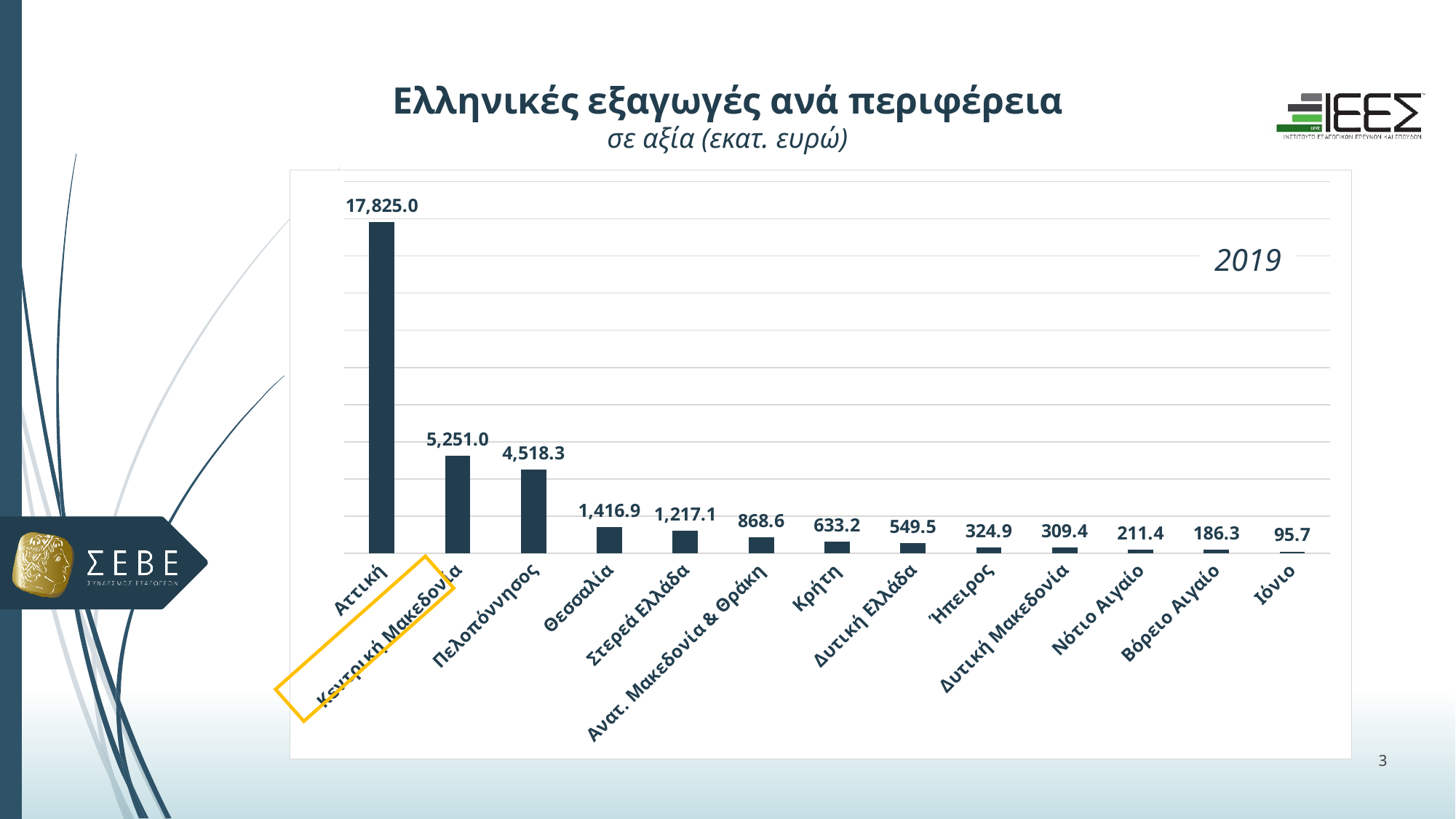
Do the export values rise or fall from left to right across the regions? Fall What is the difference between the export values of Θεσσαλία and Στερεά Ελλάδα? 199.8 Which region has the lowest export value? Ιόνιο What is the difference between the export values of Αττική and Κεντρική Μακεδονία? 12,574.0 What kind of chart is shown on the slide? Bar chart What is the export value for Νότιο Αιγαίο? 211.4 What is the export value for Κρήτη? 633.2 What is the export value for Αττική? 17,825.0 Which region has the highest export value? Αττική Which has a larger export value, Ήπειρος or Δυτική Μακεδονία? Ήπειρος How many regions are shown in the chart? 13 What is the export value for Πελοπόννησος? 4,518.3